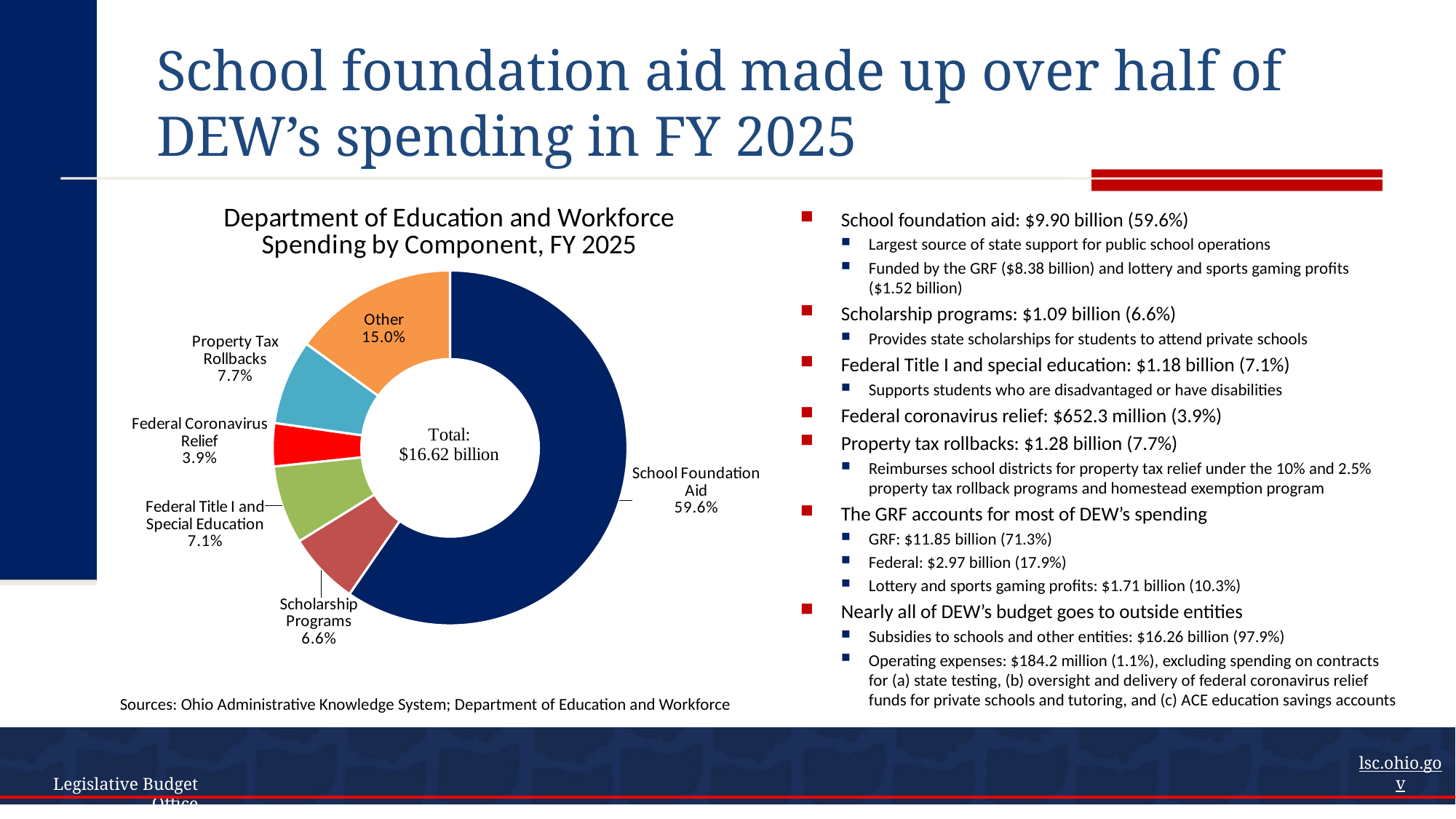
What kind of chart is shown on the slide? Pie chart (donut) What is the title of the chart? Department of Education and Workforce Spending by Component, FY 2025 What percentage is shown for Scholarship Programs? 6.6% What share of spending does School Foundation Aid represent in the chart? 59.6% How many components (slices) are shown in the chart? 6 What percentage is shown for Federal Coronavirus Relief? 3.9% What percentage is shown for Property Tax Rollbacks? 7.7% What percentage is shown for Other? 15.0% What total spending amount is shown in the center of the chart? $16.62 billion Which component has the smallest share of spending in the chart? Federal Coronavirus Relief Which component has the largest share of spending in the chart? School Foundation Aid What is the difference in percentage points between Property Tax Rollbacks and Federal Title I and Special Education? 0.6 percentage points